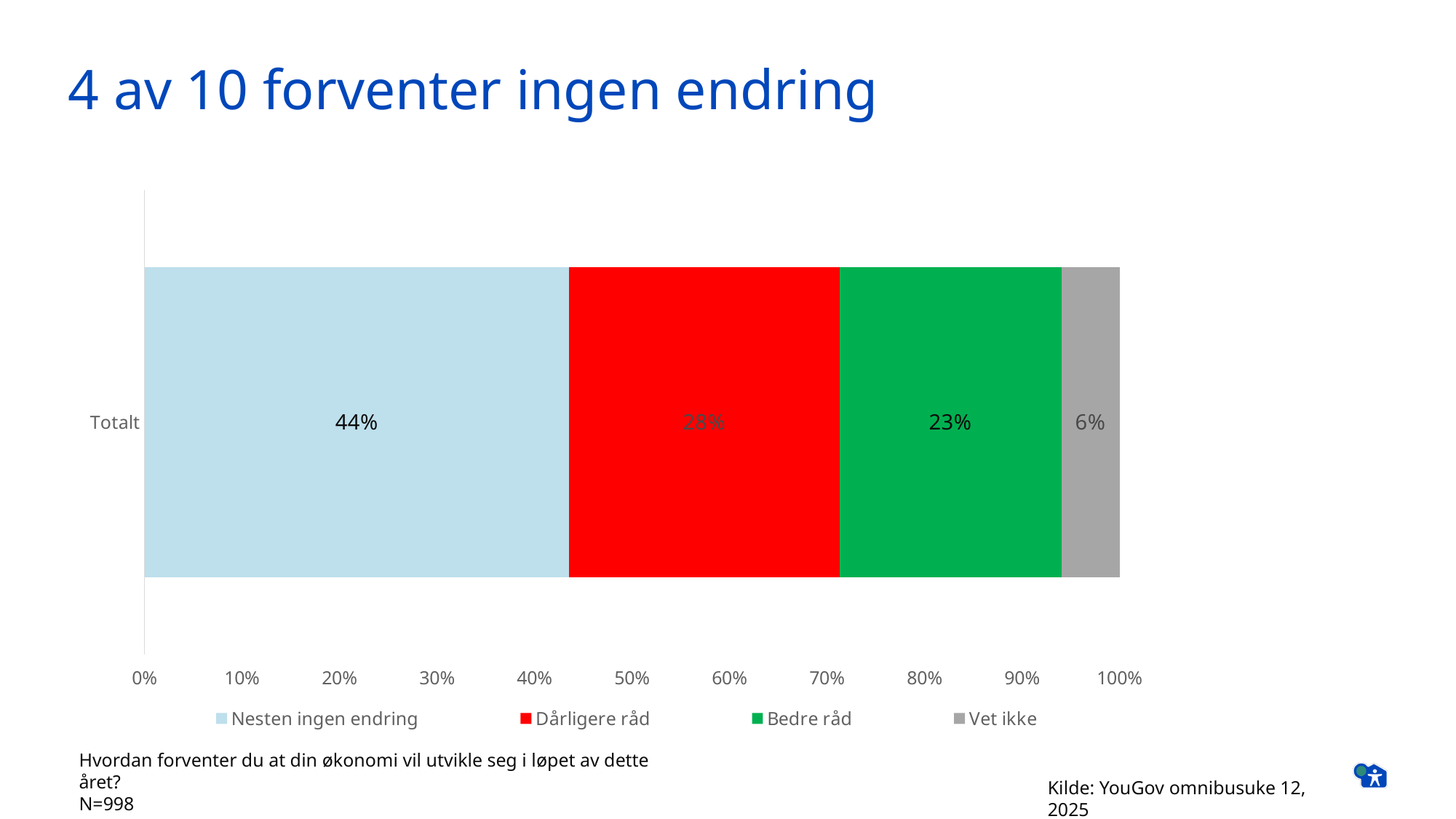
Which response category has the smallest share? Vet ikke What kind of chart is shown on the slide? Stacked bar chart Which response category has the largest share? Nesten ingen endring What share of respondents expect "Bedre råd"? 23% What is the difference in percentage points between "Nesten ingen endring" and "Dårligere råd"? 16 percentage points How many series does the legend list? 4 What colour represents "Dårligere råd" in the chart? Red Which is larger, the share for "Dårligere råd" or for "Bedre råd"? Dårligere råd What percentage of respondents answered "Nesten ingen endring"? 44% What is the value for "Dårligere råd" in the Totalt bar? 28% What is the total of the Totalt stacked bar? 101% What is the value for "Vet ikke"? 6%